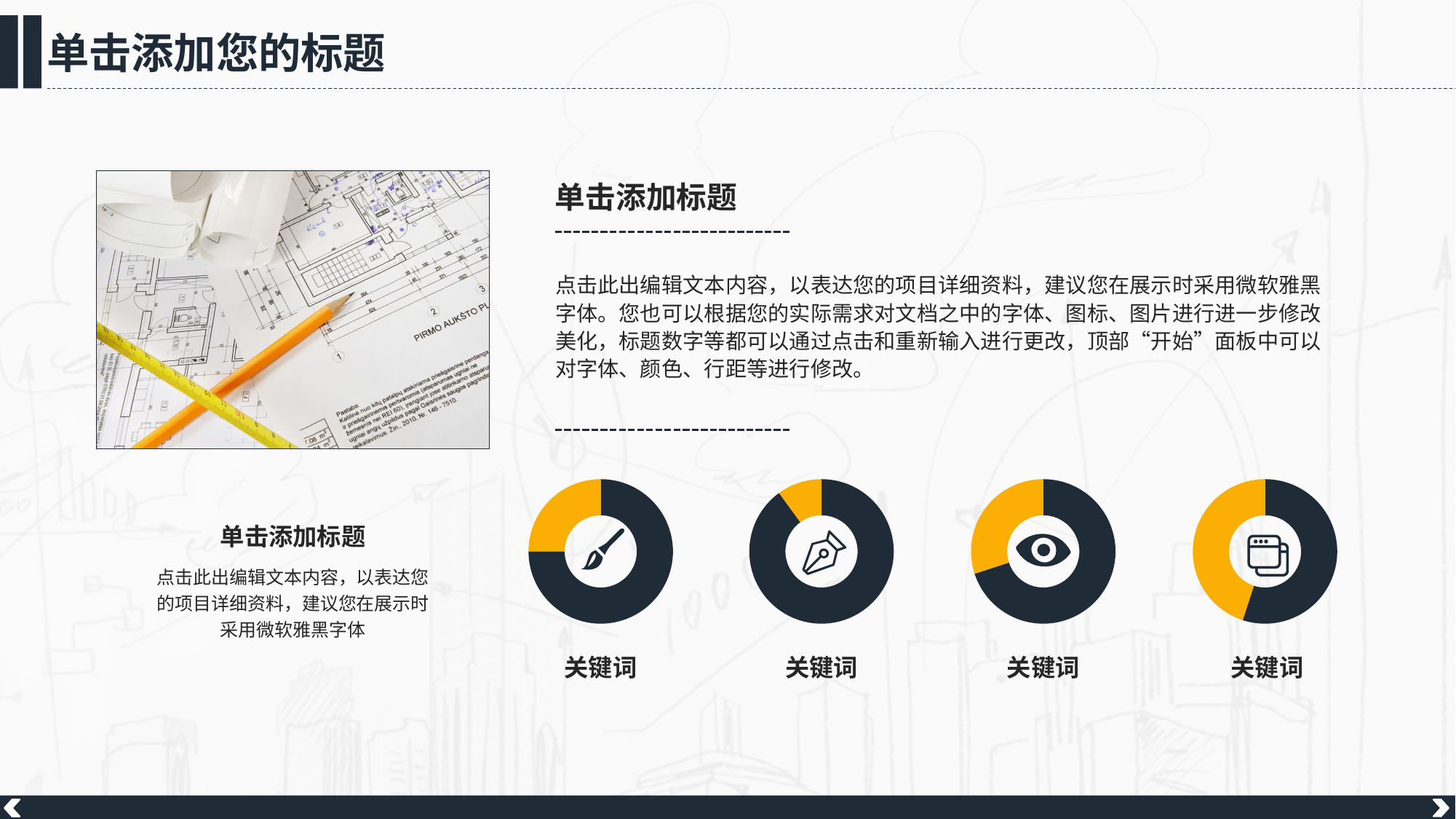
What two colours are used for the segments of the donut charts? Yellow and dark navy In the leftmost donut chart, which segment is larger, the yellow one or the dark one? The dark one Which of the four donut charts has the smallest yellow segment? The second from the left What kind of chart is used for the four charts at the bottom of the slide? Donut (pie) chart How many segments does each donut chart at the bottom of the slide have? 2 How many donut charts are shown on the slide? 4 In the third donut chart from the left, which segment is larger, the yellow one or the dark one? The dark one In the second donut chart from the left, which segment is larger, the yellow one or the dark one? The dark one Which of the four donut charts has the largest yellow segment? The rightmost one What label appears under each of the four donut charts? 关键词